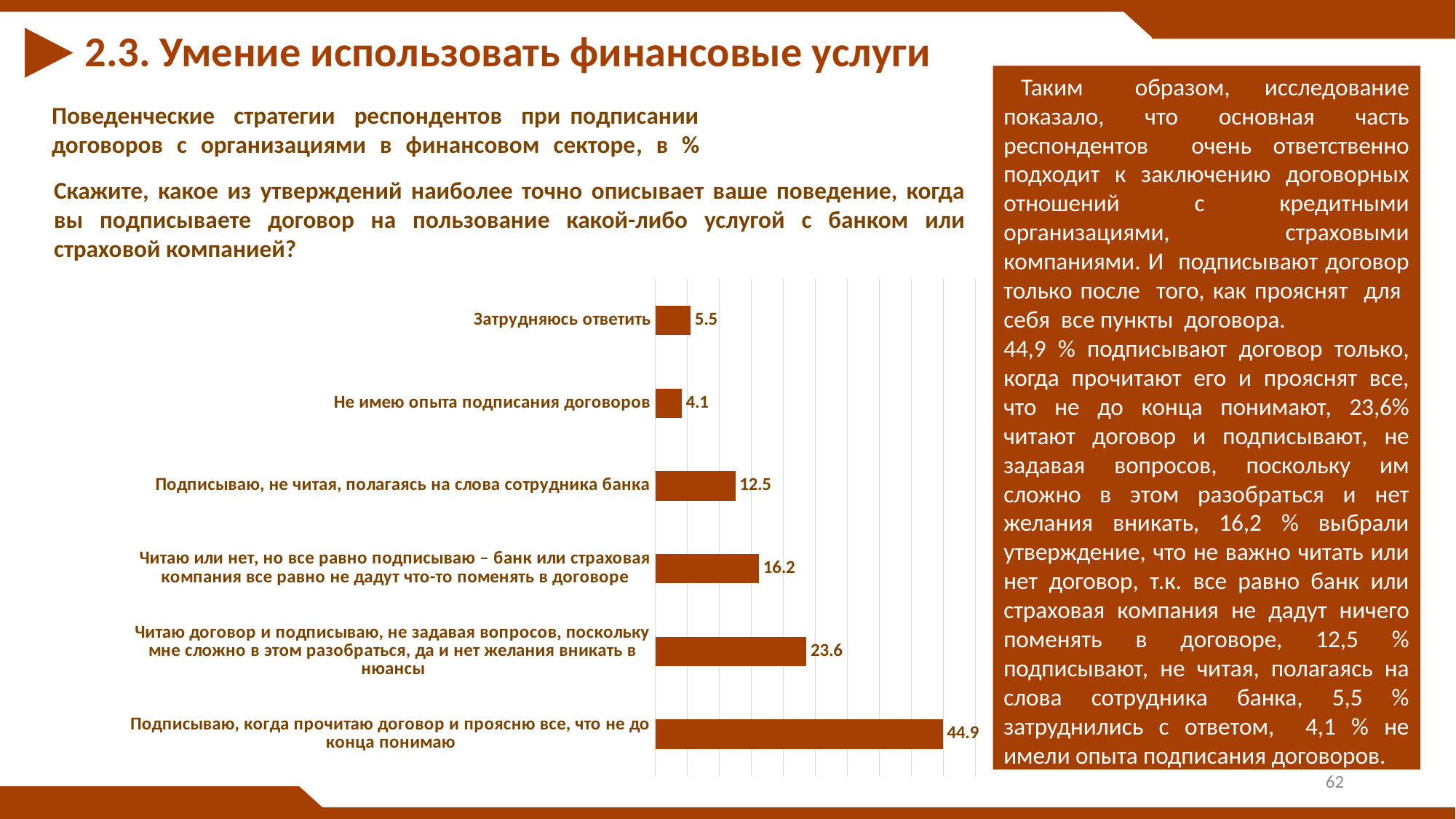
What colour are the bars in the chart? Brown Which category has the lowest value in the chart? Не имею опыта подписания договоров How many categories are shown in the chart? 6 What value is shown for "Не имею опыта подписания договоров"? 4.1 What value is shown for "Подписываю, когда прочитаю договор и проясню все, что не до конца понимаю"? 44.9 Which is larger: the value for "Подписываю, не читая, полагаясь на слова сотрудника банка" or the value for "Затрудняюсь ответить"? Подписываю, не читая, полагаясь на слова сотрудника банка What value is shown for "Подписываю, не читая, полагаясь на слова сотрудника банка"? 12.5 What kind of chart is shown on the slide? Bar chart What is the difference between the highest value (44.9) and the lowest value (4.1) in the chart? 40.8 Which category has the highest value in the chart? Подписываю, когда прочитаю договор и проясню все, что не до конца понимаю What is the difference between the values for "Читаю договор и подписываю, не задавая вопросов..." (23.6) and "Читаю или нет, но все равно подписываю..." (16.2)? 7.4 What value is shown for "Затрудняюсь ответить"? 5.5